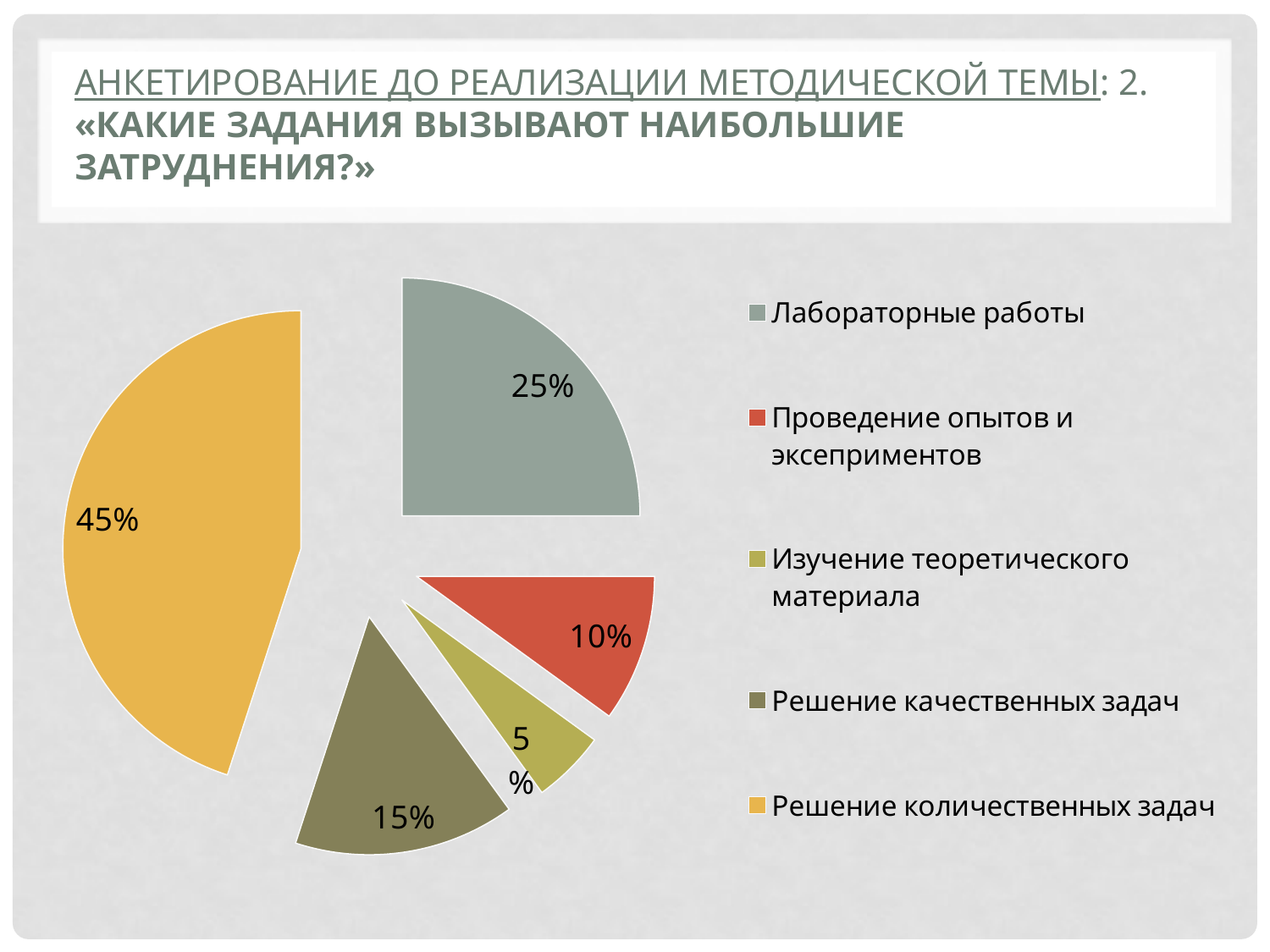
What share of the pie does «Решение количественных задач» have? 45% How many categories does the legend list? 5 What share of the pie does «Проведение опытов и эксеприментов» have? 10% Which is larger: the share of «Решение качественных задач» or «Проведение опытов и эксеприментов»? Решение качественных задач What is the difference between the shares of «Решение количественных задач» and «Лабораторные работы»? 20% What share of the pie does «Лабораторные работы» have? 25% What share of the pie does «Решение качественных задач» have? 15% What share of the pie does «Изучение теоретического материала» have? 5% Which category has the smallest slice of the pie? Изучение теоретического материала Which category has the largest slice of the pie? Решение количественных задач What kind of chart is shown on the slide? pie chart What colour is the slice for «Решение количественных задач»? yellow